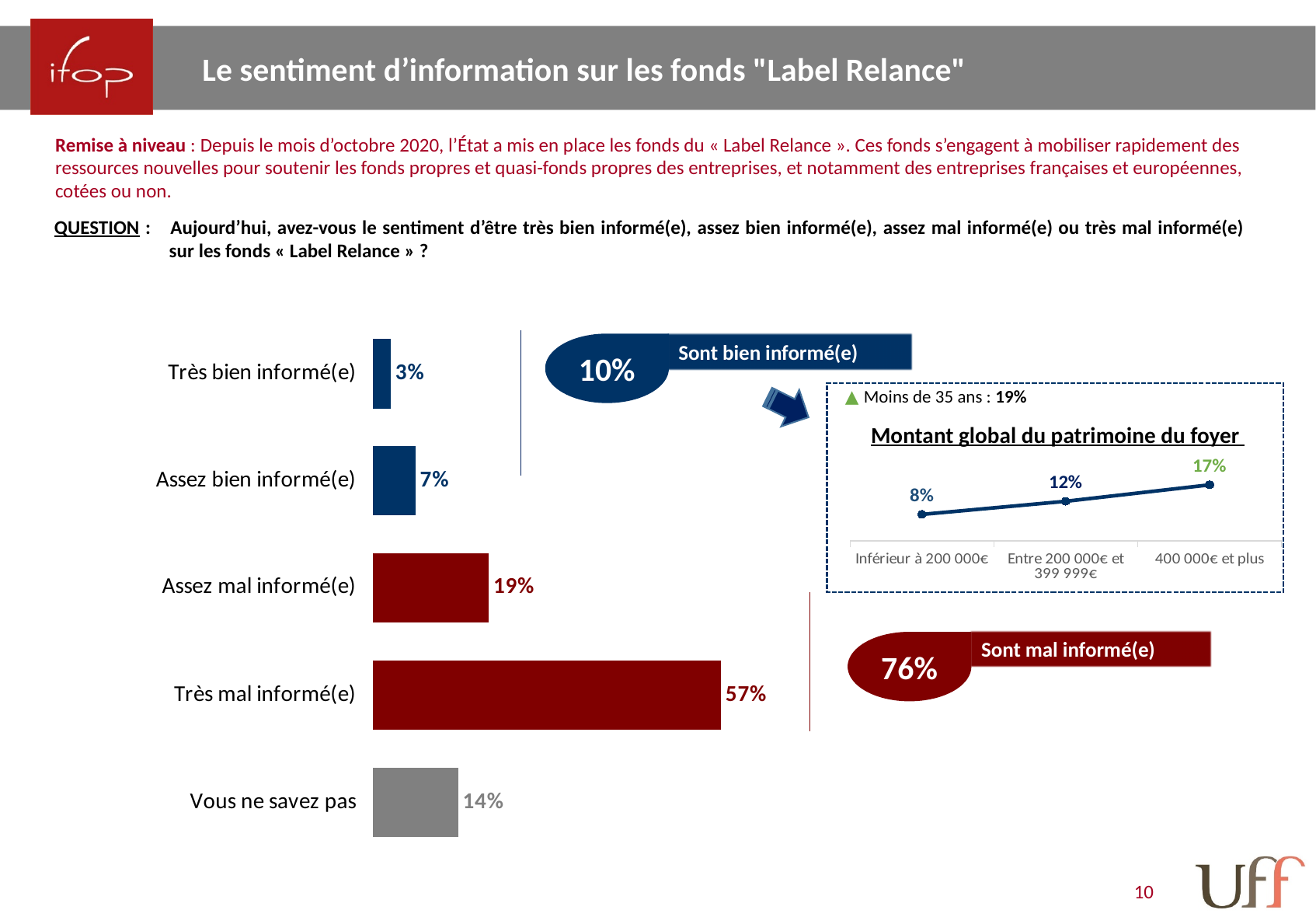
In the bar chart on the left, what is the value for "Très mal informé(e)"? 57% In the bar chart on the left, which is larger: "Assez mal informé(e)" or "Vous ne savez pas"? Assez mal informé(e) In the bar chart on the left, which category has the lowest value? Très bien informé(e) What kind of chart is the chart on the left? Bar chart How many categories does the bar chart on the left show? 5 In the bar chart on the left, what is the difference between "Assez mal informé(e)" and "Vous ne savez pas"? 5% How many data points does the line chart "Montant global du patrimoine du foyer" show? 3 In the bar chart on the left, which category has the highest value? Très mal informé(e) In the bar chart on the left, what is the value for "Assez bien informé(e)"? 7% In the line chart "Montant global du patrimoine du foyer", what is the value for "Entre 200 000€ et 399 999€"? 12% In the line chart "Montant global du patrimoine du foyer", what is the difference between "400 000€ et plus" and "Inférieur à 200 000€"? 9% In the line chart "Montant global du patrimoine du foyer", do the values rise or fall from left to right? Rise